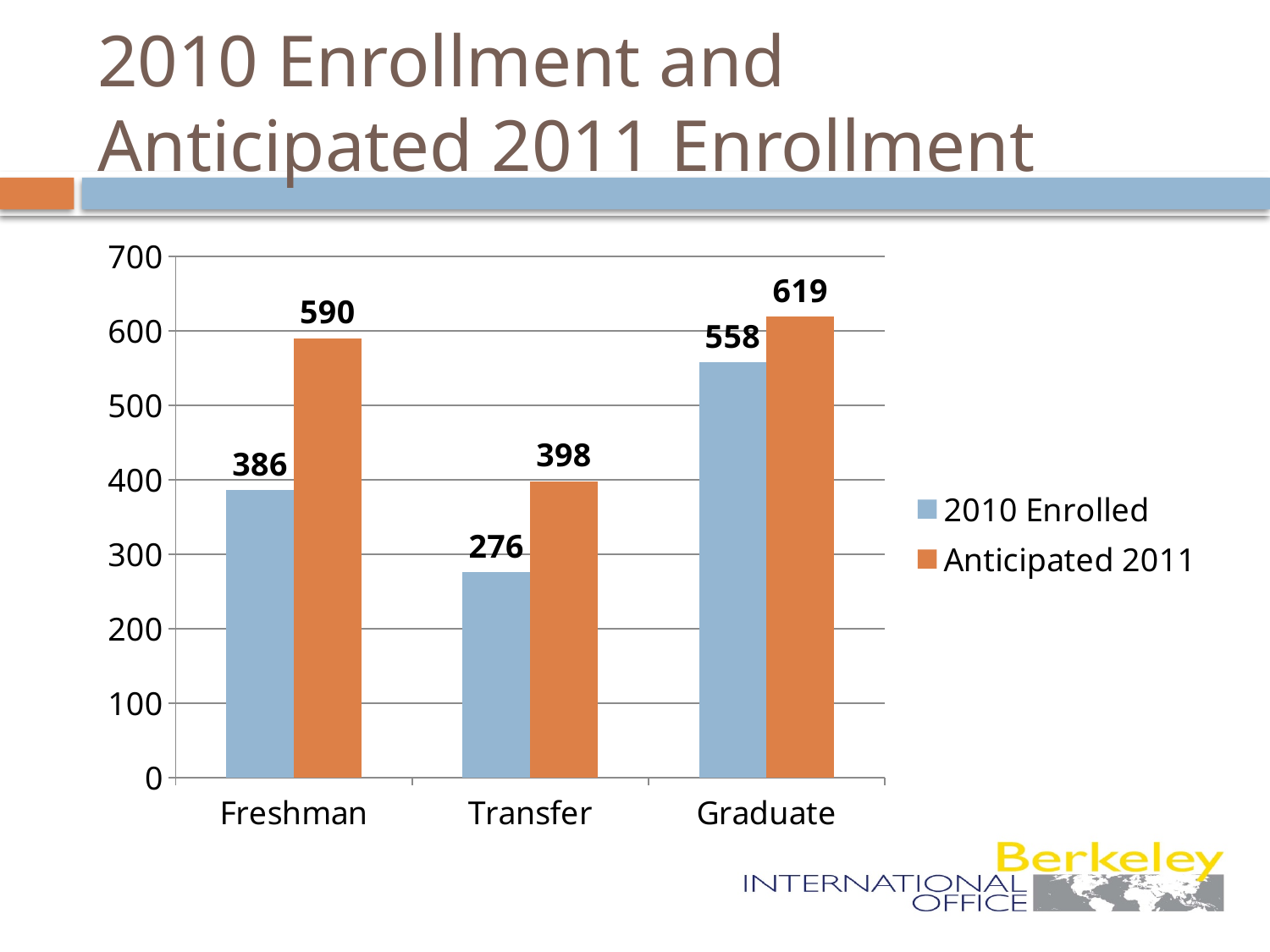
What is the difference between the Graduate and Transfer 2010 Enrolled values? 282 What is the difference between the Anticipated 2011 and 2010 Enrolled values for Freshman? 204 What kind of chart is shown on the slide? Bar chart What is the Anticipated 2011 value for Graduate? 619 How many categories are shown on the x axis? 3 Which is larger: the 2010 Enrolled value for Freshman or the 2010 Enrolled value for Transfer? Freshman Which colour represents the Anticipated 2011 series? Orange What is the 2010 Enrolled value for Freshman? 386 What is the Anticipated 2011 value for Transfer? 398 Which category has the highest 2010 Enrolled value? Graduate How many series does the legend list? 2 Which category has the lowest Anticipated 2011 value? Transfer